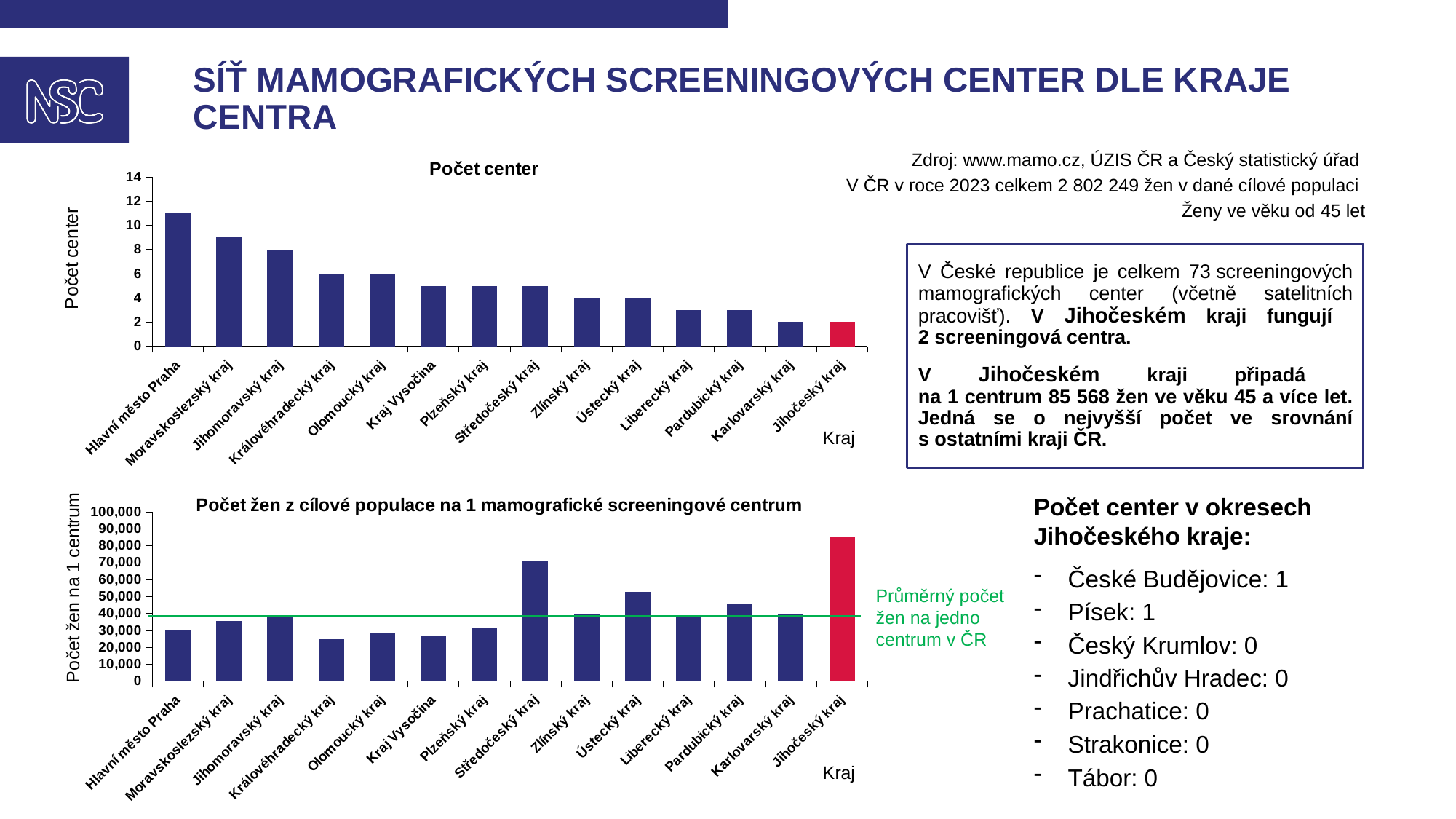
In the 'Počet center' chart, do the values generally rise or fall from left to right along the x axis? fall In the 'Počet žen z cílové populace na 1 mamografické screeningové centrum' chart, what does the green horizontal line represent? Průměrný počet žen na jedno centrum v ČR In the 'Počet center' chart, which region has the highest number of centres? Hlavní město Praha In the 'Počet žen z cílové populace na 1 mamografické screeningové centrum' chart, which is larger, the value for Středočeský kraj or Ústecký kraj? Středočeský kraj In the 'Počet center' chart, how many regions (kraje) are shown on the x axis? 14 In the 'Počet center' chart, what is the value for Jihočeský kraj? 2 In the 'Počet center' chart, what is the value for Královéhradecký kraj? 6 What kind of chart is the 'Počet center' chart? bar chart In the 'Počet center' chart, which has more centres, Hlavní město Praha or Moravskoslezský kraj? Hlavní město Praha In the 'Počet žen z cílové populace na 1 mamografické screeningové centrum' chart, is the value for Středočeský kraj greater or less than 60,000? greater In the 'Počet žen z cílové populace na 1 mamografické screeningové centrum' chart, which region has the highest value? Jihočeský kraj In the 'Počet center' chart, is the value for Hlavní město Praha greater or less than 10? greater